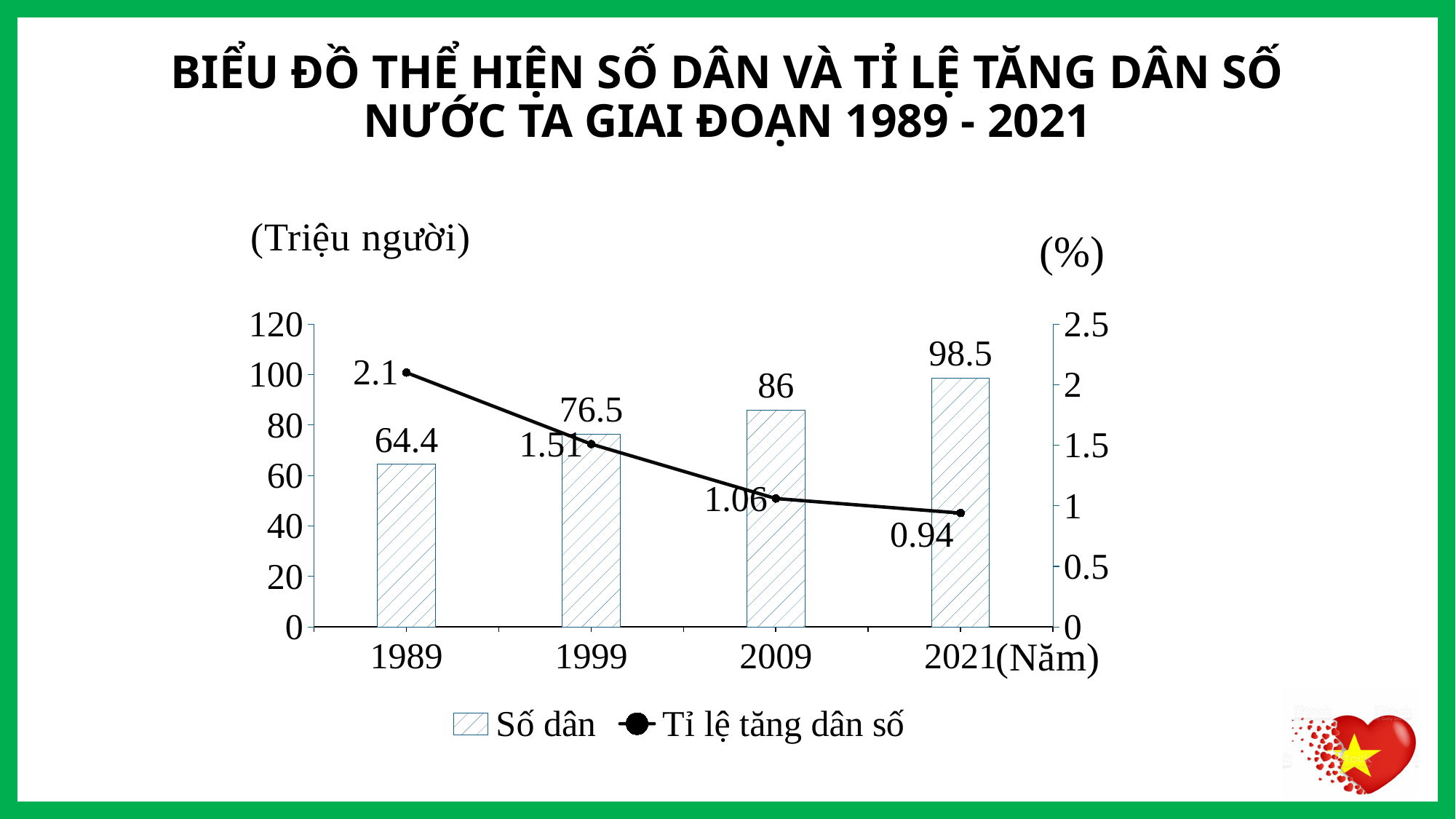
What unit is shown on the right-hand axis? (%) Does Tỉ lệ tăng dân số rise or fall from 1989 to 2021? fall Which is larger, Số dân in 1999 or in 2009? 2009 Which year has the lowest Tỉ lệ tăng dân số? 2021 What is the value of Số dân for 1989? 64.4 What is the value of Số dân for 2021? 98.5 How many years are shown on the x axis? 4 What is the value of Tỉ lệ tăng dân số for 2009? 1.06 What kind of chart is used for Số dân? bar chart How many series does the legend list? 2 What is the difference in Số dân between 2021 and 1989? 34.1 Which year has the highest Số dân? 2021